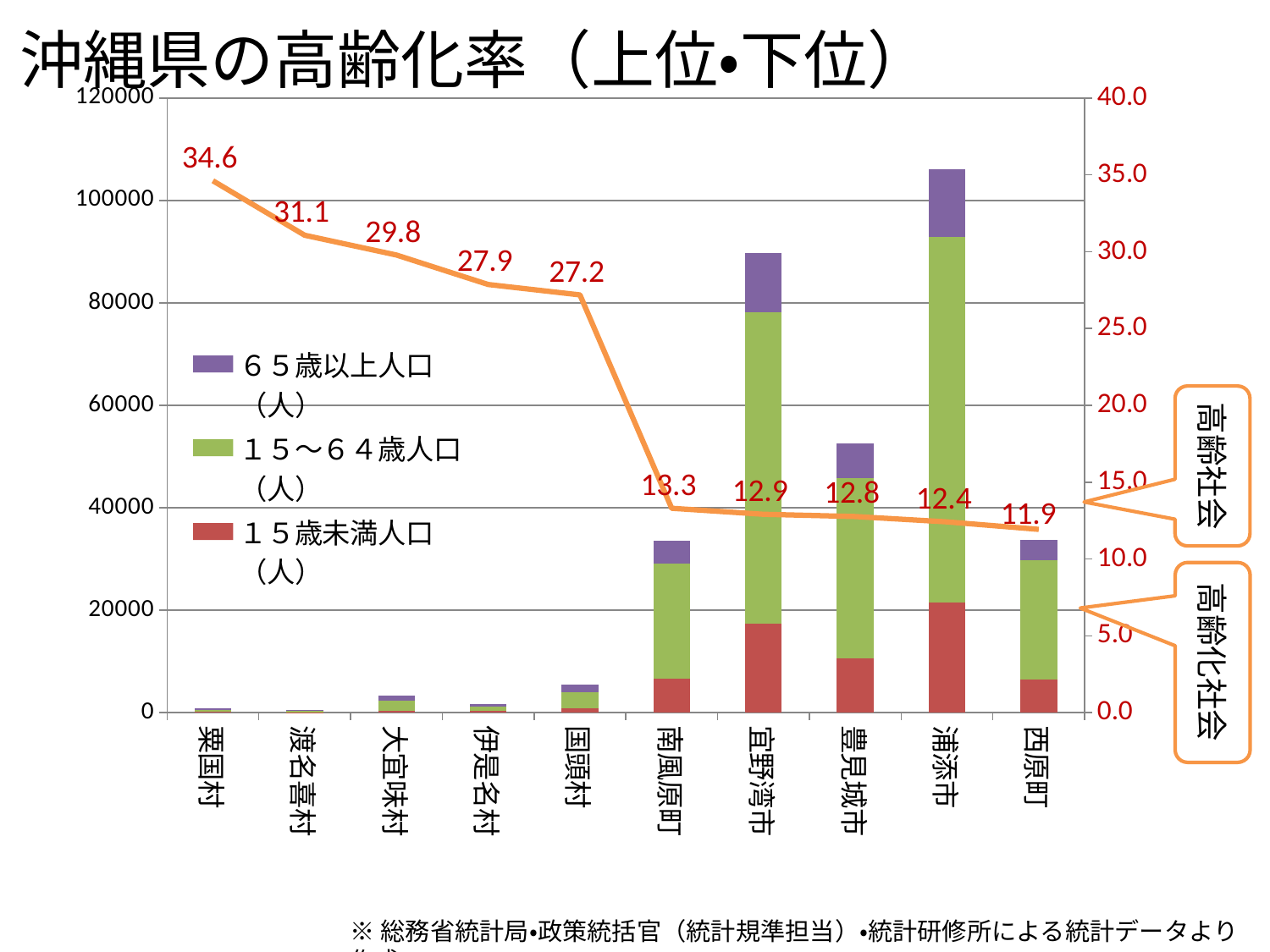
What is the aging rate (line value) shown for 粟国村? 34.6 How many series does the legend list? 3 Is the total population bar for 浦添市 greater or less than 100000? greater What is the aging rate (line value) shown for 西原町? 11.9 What is the difference between the aging rate of 粟国村 and that of 西原町? 22.7 Which municipality has the highest aging rate on the line? 粟国村 Which has the higher aging rate, 南風原町 or 宜野湾市? 南風原町 How many municipalities are shown on the x axis? 10 Is the total population bar for 豊見城市 greater or less than 60000? less Which municipality has the lowest aging rate on the line? 西原町 Does the aging rate line rise or fall from left to right across the x axis? fall What is the aging rate (line value) shown for 南風原町? 13.3